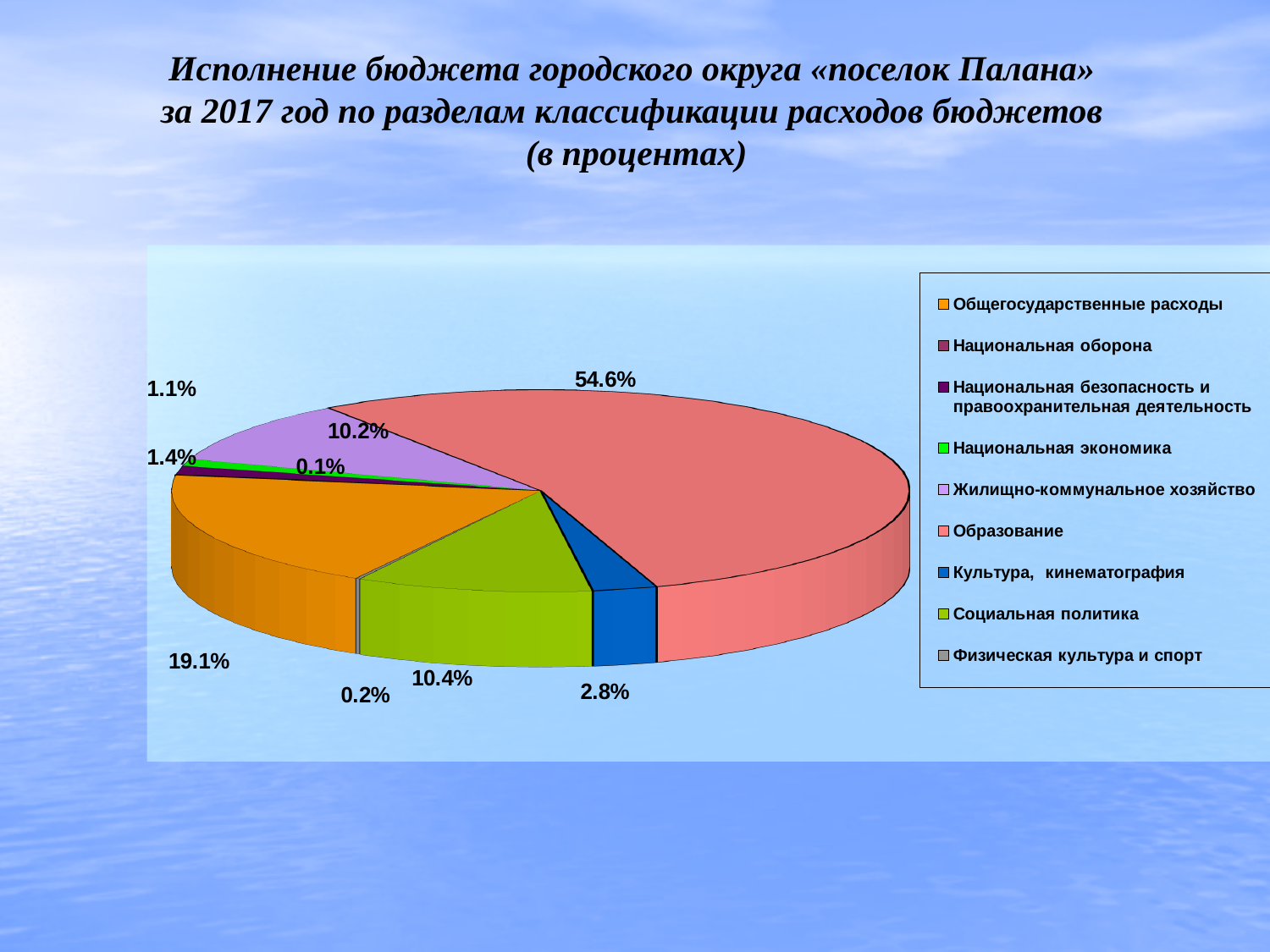
What percentage of the budget went to Образование? 54.6% Which category has the largest share of the pie? Образование What percentage is shown for Физическая культура и спорт? 0.2% What is the difference in percentage points between Образование and Общегосударственные расходы? 35.5 What percentage is shown for Культура, кинематография? 2.8% What type of chart is shown on the slide? Pie chart What percentage is shown for Общегосударственные расходы? 19.1% How many categories does the legend list? 9 What percentage is shown for Социальная политика? 10.4% What percentage is shown for Жилищно-коммунальное хозяйство? 10.2% Which is larger: the share for Общегосударственные расходы or for Социальная политика? Общегосударственные расходы What is the smallest percentage value labelled on the pie chart? 0.1%